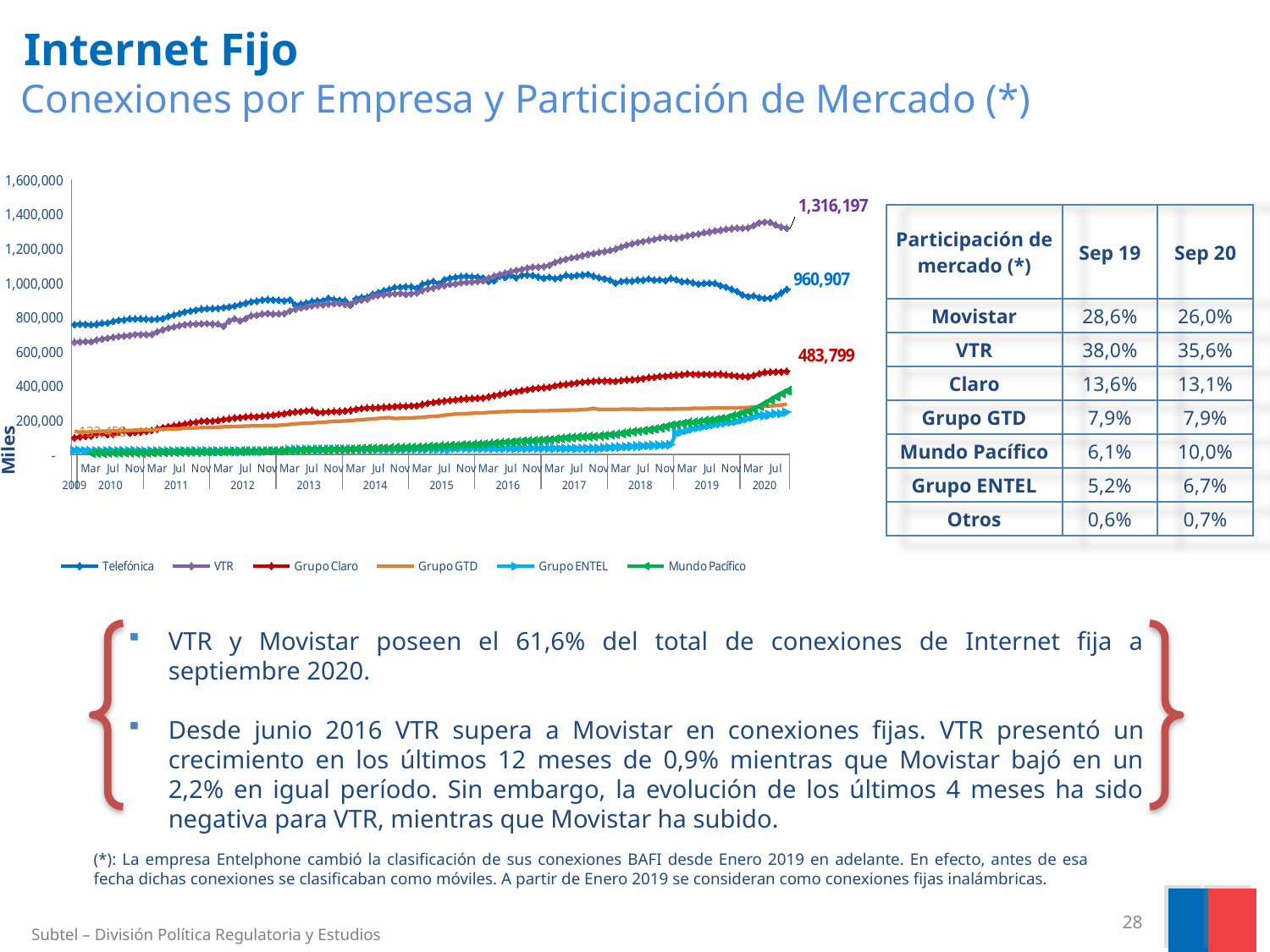
At the end of the chart, which series is higher: VTR or Telefónica? VTR What kind of chart is shown on the slide? Line chart What is the first year shown on the x axis of the chart? 2009 What is the difference between the latest labelled values for Telefónica and Grupo Claro? 477,108 Which series has the highest value at the end of the chart? VTR What is the latest value labelled for VTR on the chart? 1,316,197 What is the difference between the latest labelled values for VTR and Telefónica? 355,290 What is the latest value labelled for Grupo Claro on the chart? 483,799 Does the VTR series rise or fall over the period shown on the chart? Rises What is the latest value labelled for Telefónica on the chart? 960,907 How many series does the chart legend list? 6 Is the value for Grupo GTD at the end of the chart greater or less than 400,000? less